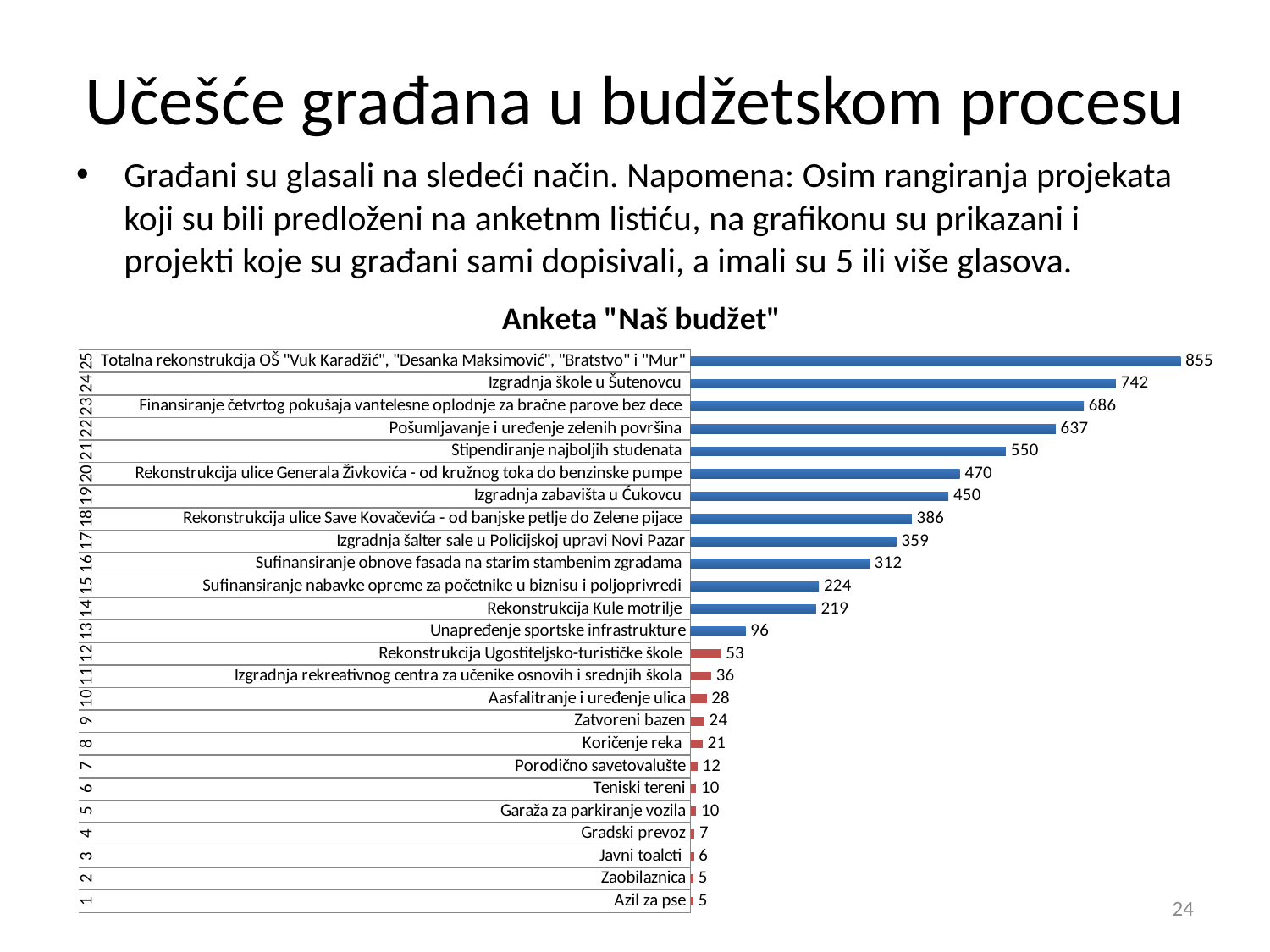
What is the value for "Rekonstrukcija Kule motrilje"? 219 How many categories are shown in the chart? 25 What is the difference between "Izgradnja škole u Šutenovcu" and "Finansiranje četvrtog pokušaja vantelesne oplodnje za bračne parove bez dece"? 56 Which category has the highest value? Totalna rekonstrukcija OŠ "Vuk Karadžić", "Desanka Maksimović", "Bratstvo" i "Mur" What is the value for "Stipendiranje najboljih studenata"? 550 What is the difference between "Rekonstrukcija ulice Generala Živkovića - od kružnog toka do benzinske pumpe" and "Izgradnja zabavišta u Čukovcu"? 20 What is the value for "Izgradnja škole u Šutenovcu"? 742 What is the title of the chart? Anketa "Naš budžet" Which is larger, "Sufinansiranje obnove fasada na starim stambenim zgradama" or "Izgradnja šalter sale u Policijskoj upravi Novi Pazar"? Izgradnja šalter sale u Policijskoj upravi Novi Pazar What is the value of the highest bar? 855 What is the value for "Zatvoreni bazen"? 24 What kind of chart is shown on the slide? Bar chart